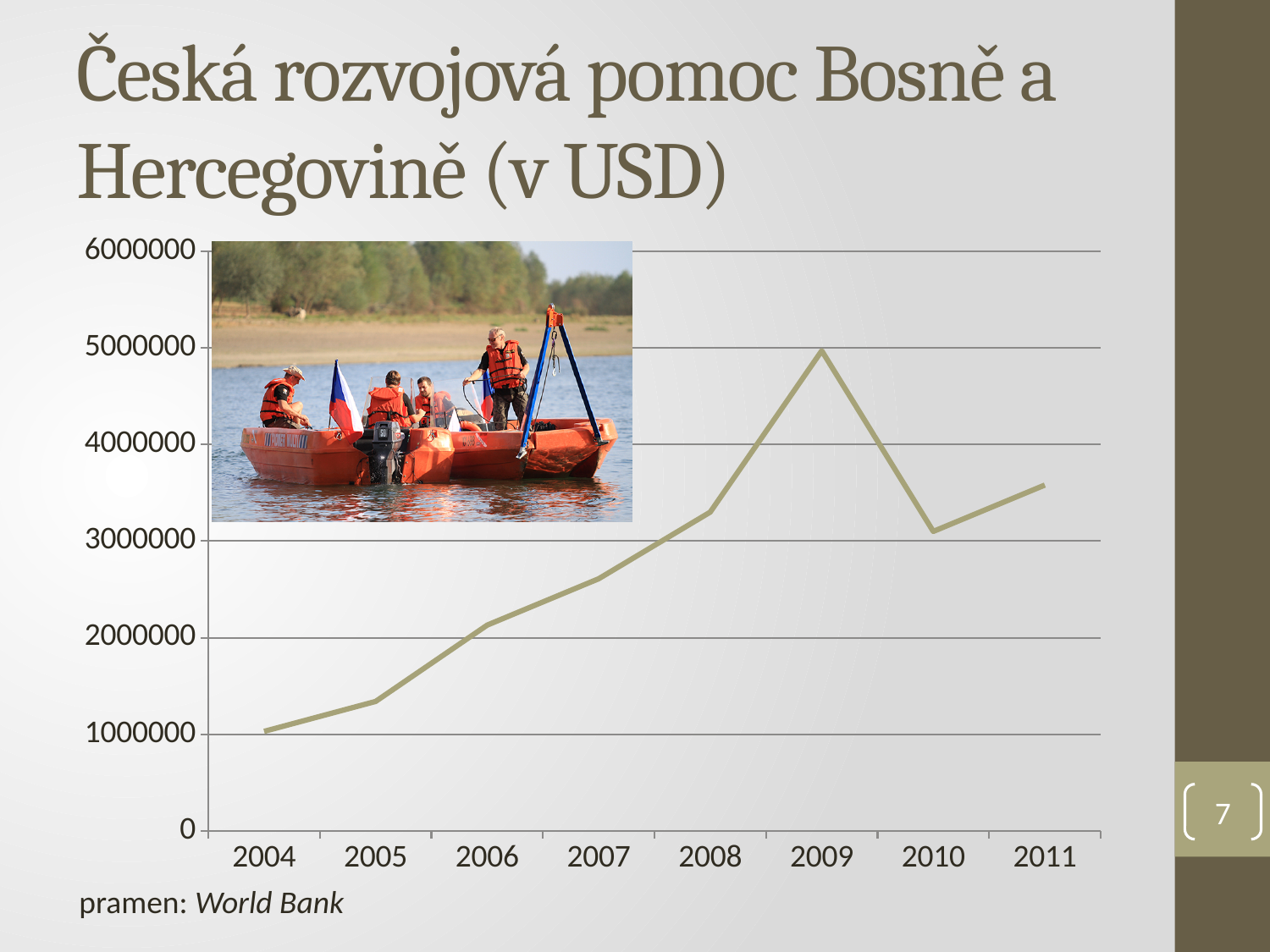
Which year has the larger value, 2010 or 2011? 2011 Is the value for 2009 greater or less than 4000000? greater In which year was Czech development aid to Bosnia and Herzegovina lowest? 2004 In which year was Czech development aid to Bosnia and Herzegovina highest? 2009 Do the values rise or fall from 2004 to 2009? rise What kind of chart is shown on the slide? line chart Is the value for 2004 greater or less than 2000000? less Is the value for 2008 greater or less than 3000000? greater Which year has the larger value, 2009 or 2010? 2009 How many years are plotted on the x axis of the chart? 8 What source is cited for the chart data? World Bank